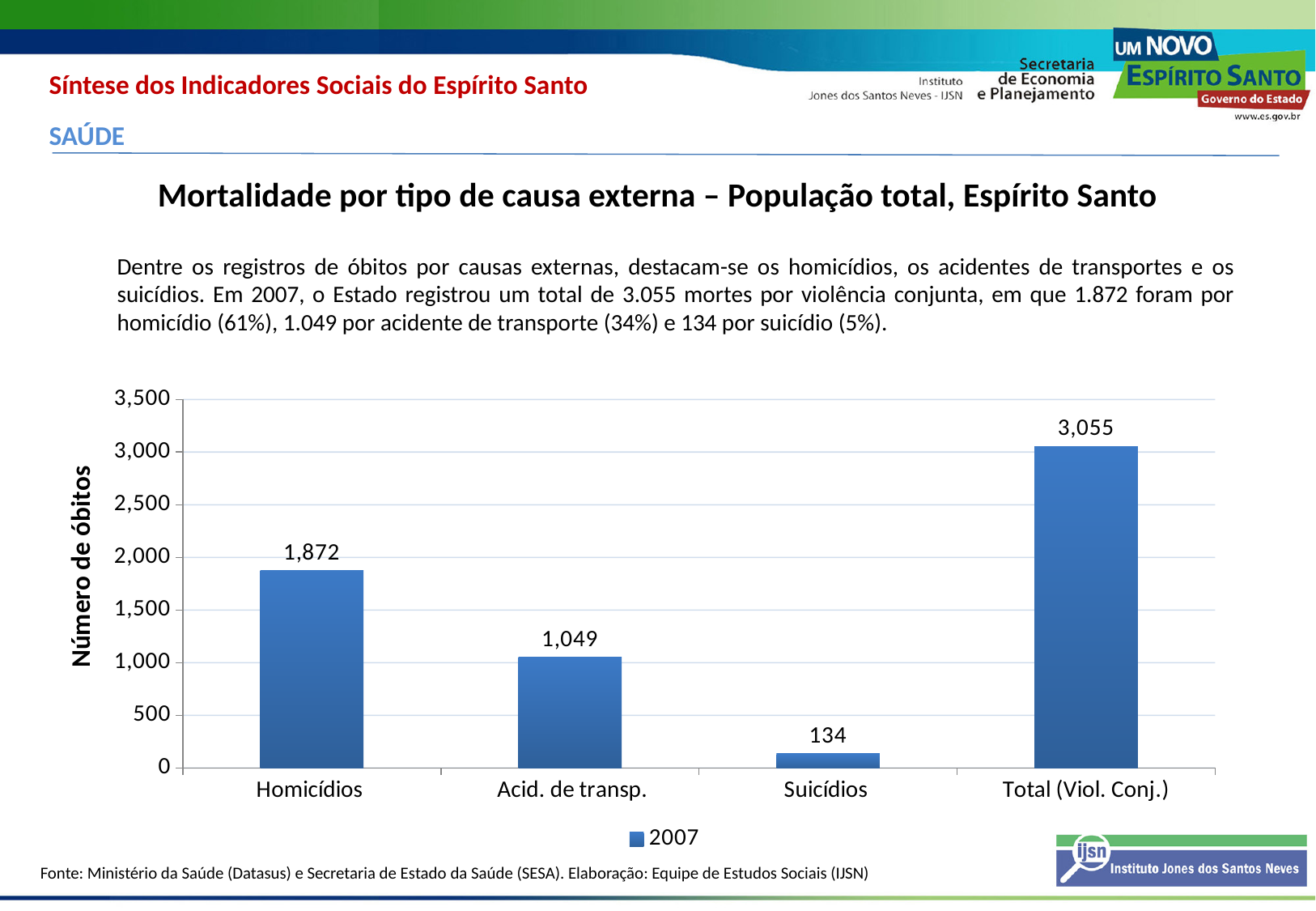
What is the value for Homicídios? 1,872 What is the value for Suicídios? 134 How many series does the legend list? 1 What is the value for Total (Viol. Conj.)? 3,055 What is the value for Acid. de transp.? 1,049 Which category has the lowest value? Suicídios How many categories are shown on the x axis? 4 Is the value for Homicídios greater or less than 1,500? greater What kind of chart is shown? bar chart Which category has the highest value? Total (Viol. Conj.) Which is larger, the value for Acid. de transp. or the value for Suicídios? Acid. de transp. What is the difference between the values for Homicídios and Acid. de transp.? 823